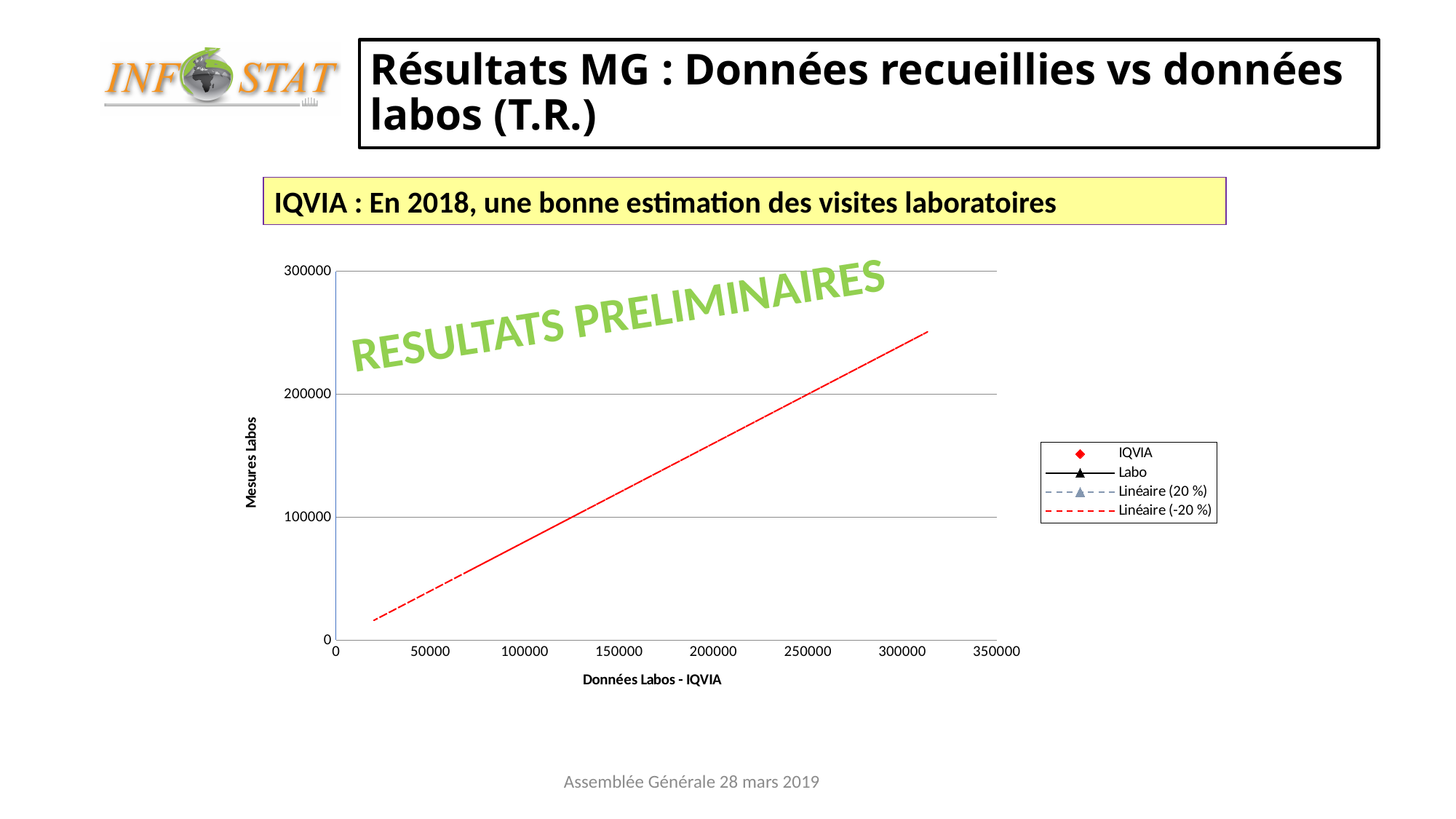
How many series does the legend list? 4 What is the title of the vertical axis? Mesures Labos What is the highest tick value shown on the horizontal axis? 350000 Is the value of the red dashed line at x = 300000 greater or less than 200000? greater Does the red dashed line rise or fall as the x-axis values increase? rise What kind of chart is shown on the slide? scatter chart with a trend line What is the title of the horizontal axis? Données Labos - IQVIA Is the value of the red dashed line at x = 100000 greater or less than 100000? less What is the highest tick value shown on the vertical axis? 300000 Is the value of the red dashed line at x = 200000 greater or less than 100000? greater